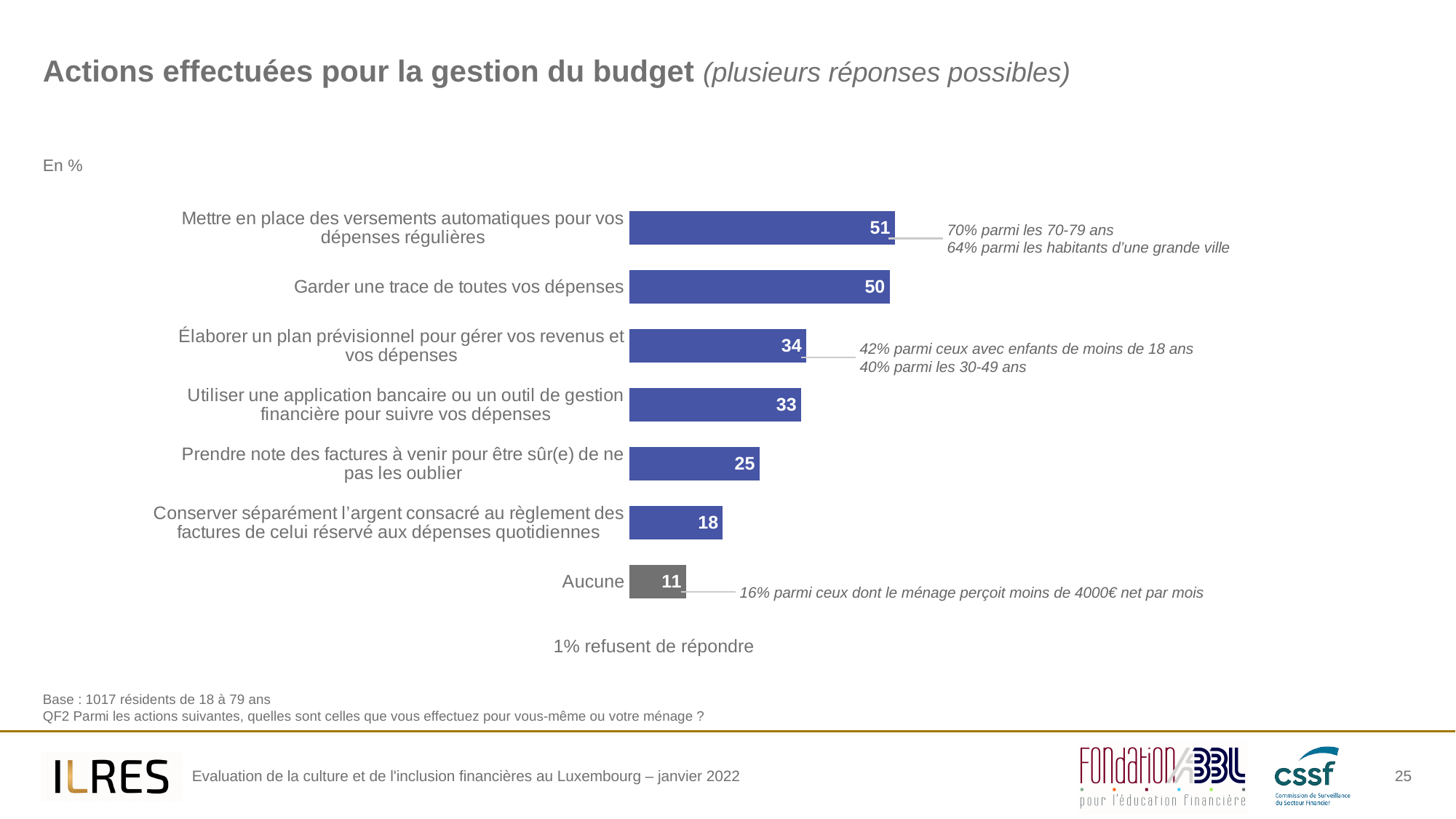
What is the value for "Utiliser une application bancaire ou un outil de gestion financière pour suivre vos dépenses"? 33 How many categories are shown in the chart? 7 What is the value for "Garder une trace de toutes vos dépenses"? 50 What is the difference between the values for "Mettre en place des versements automatiques pour vos dépenses régulières" and "Aucune"? 40 Which is larger: the value for "Élaborer un plan prévisionnel pour gérer vos revenus et vos dépenses" or for "Prendre note des factures à venir pour être sûr(e) de ne pas les oublier"? Élaborer un plan prévisionnel pour gérer vos revenus et vos dépenses What kind of chart is shown on the slide? Bar chart What is the value for "Aucune"? 11 What percentage of respondents refused to answer, according to the note below the chart? 1% What is the difference between the values for "Prendre note des factures à venir pour être sûr(e) de ne pas les oublier" and "Conserver séparément l'argent consacré au règlement des factures de celui réservé aux dépenses quotidiennes"? 7 Which category has the lowest value? Aucune What is the title of the chart? Actions effectuées pour la gestion du budget (plusieurs réponses possibles) Which action has the highest value? Mettre en place des versements automatiques pour vos dépenses régulières